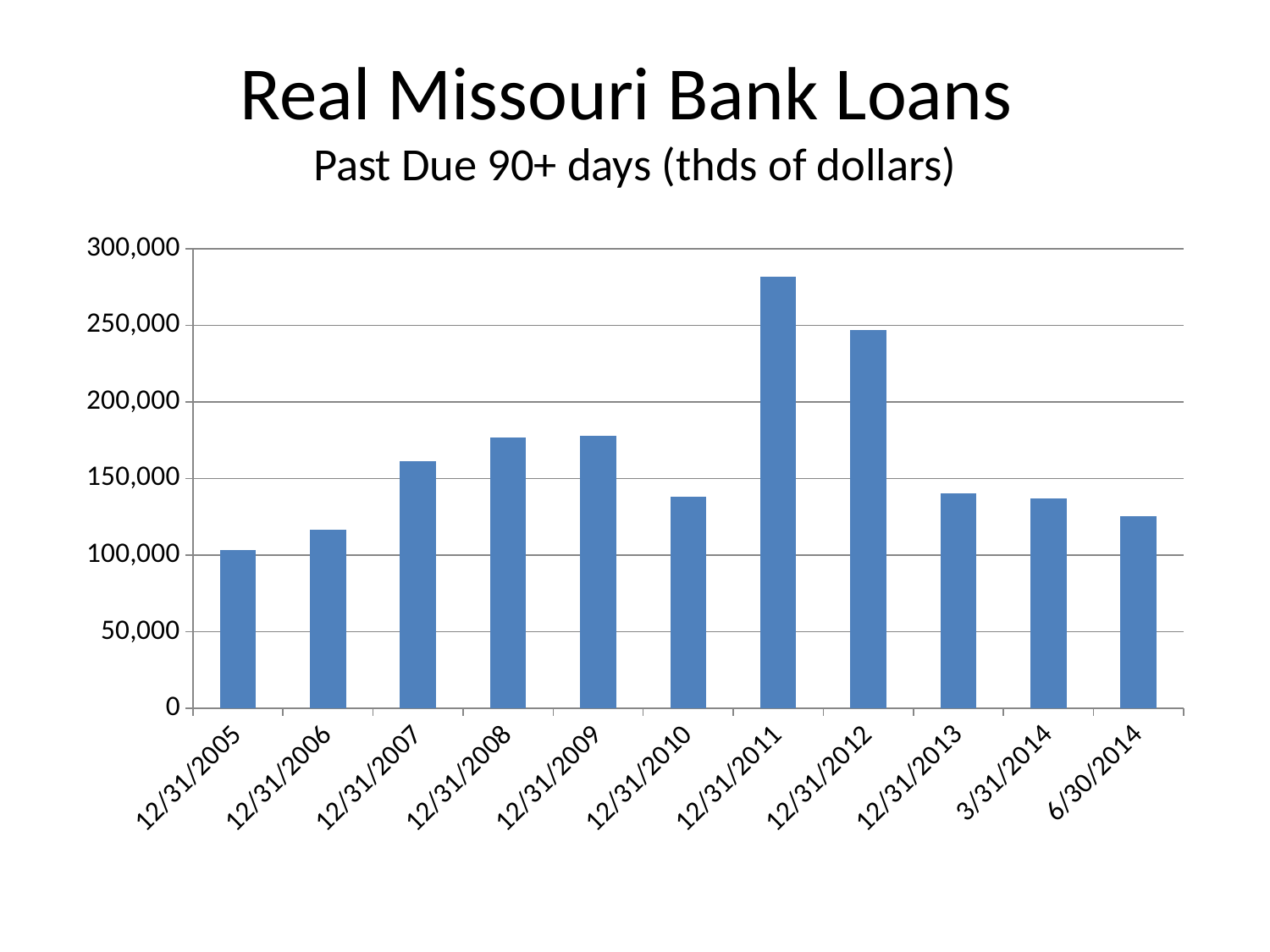
How many dates are plotted on the x axis? 11 Is the value for 12/31/2007 greater or less than 150,000? greater Which is larger, the value for 12/31/2007 or the value for 12/31/2010? 12/31/2007 What is the subtitle of the chart below the main title? Past Due 90+ days (thds of dollars) What kind of chart is shown on the slide? bar chart Do the values rise or fall from 12/31/2005 to 12/31/2009? rise Is the value for 12/31/2011 greater or less than 250,000? greater Is the value for 12/31/2010 greater or less than 150,000? less Which is larger, the value for 12/31/2011 or the value for 12/31/2012? 12/31/2011 Which date has the highest value of past due loans? 12/31/2011 Which date has the lowest value of past due loans? 12/31/2005